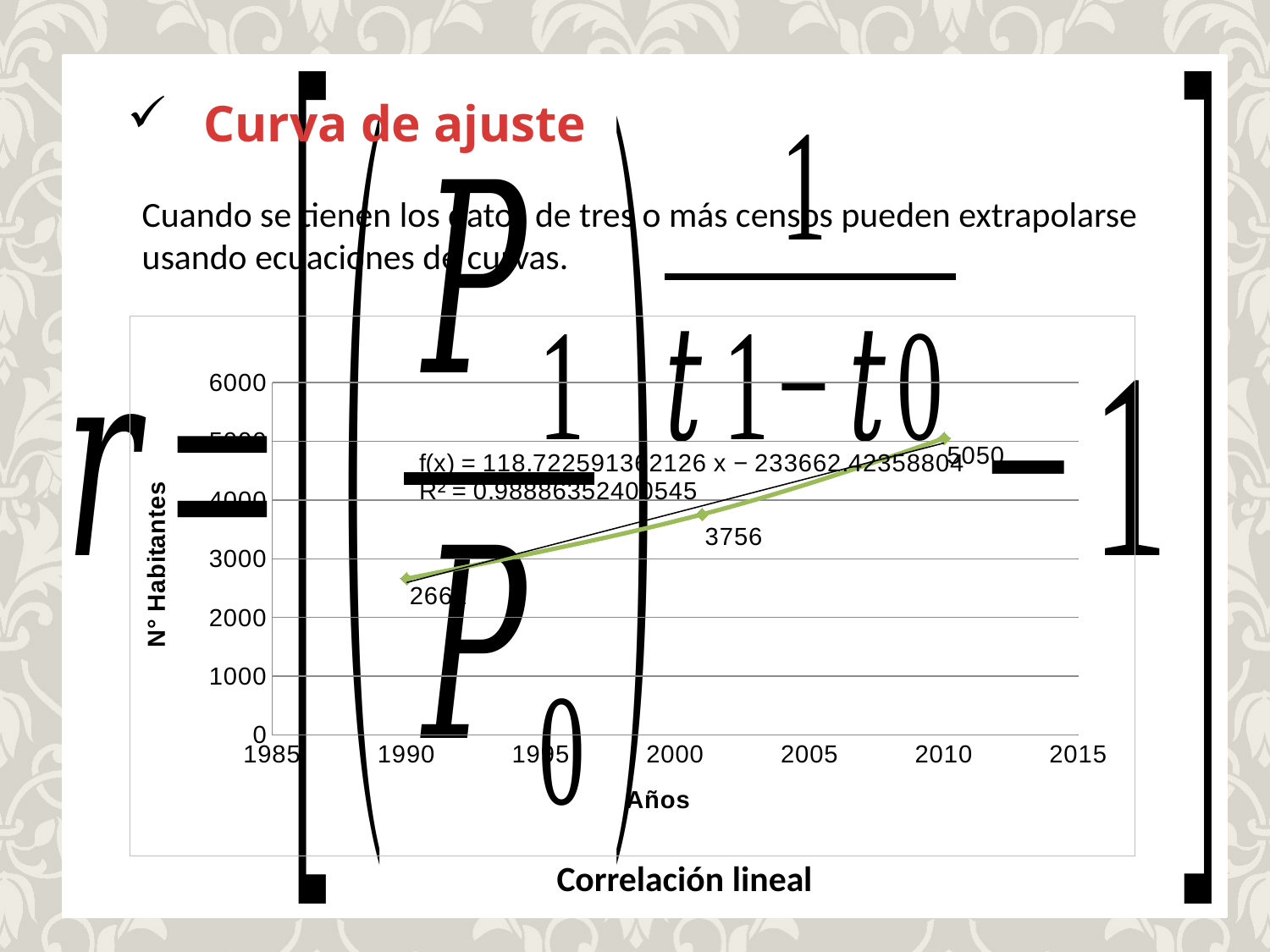
Is the value plotted for 1990 greater or less than 3000? less What is the value labelled on the middle data point of the chart? 3756 Which data point has the highest number of inhabitants? 2010 (5050) What is the difference between the value at 2010 (5050) and the middle point (3756)? 1294 Which is larger: the value at 2010 or the value at the middle point? the value at 2010 Do the plotted values rise or fall as the years increase? rise Is the value plotted for 1990 greater or less than 2000? greater How many data points are plotted on the chart? 3 What is the number of inhabitants plotted for the year 2010? 5050 What kind of chart is shown on the slide? line chart What is the title of the vertical axis? N° Habitantes What is the title of the horizontal axis? Años